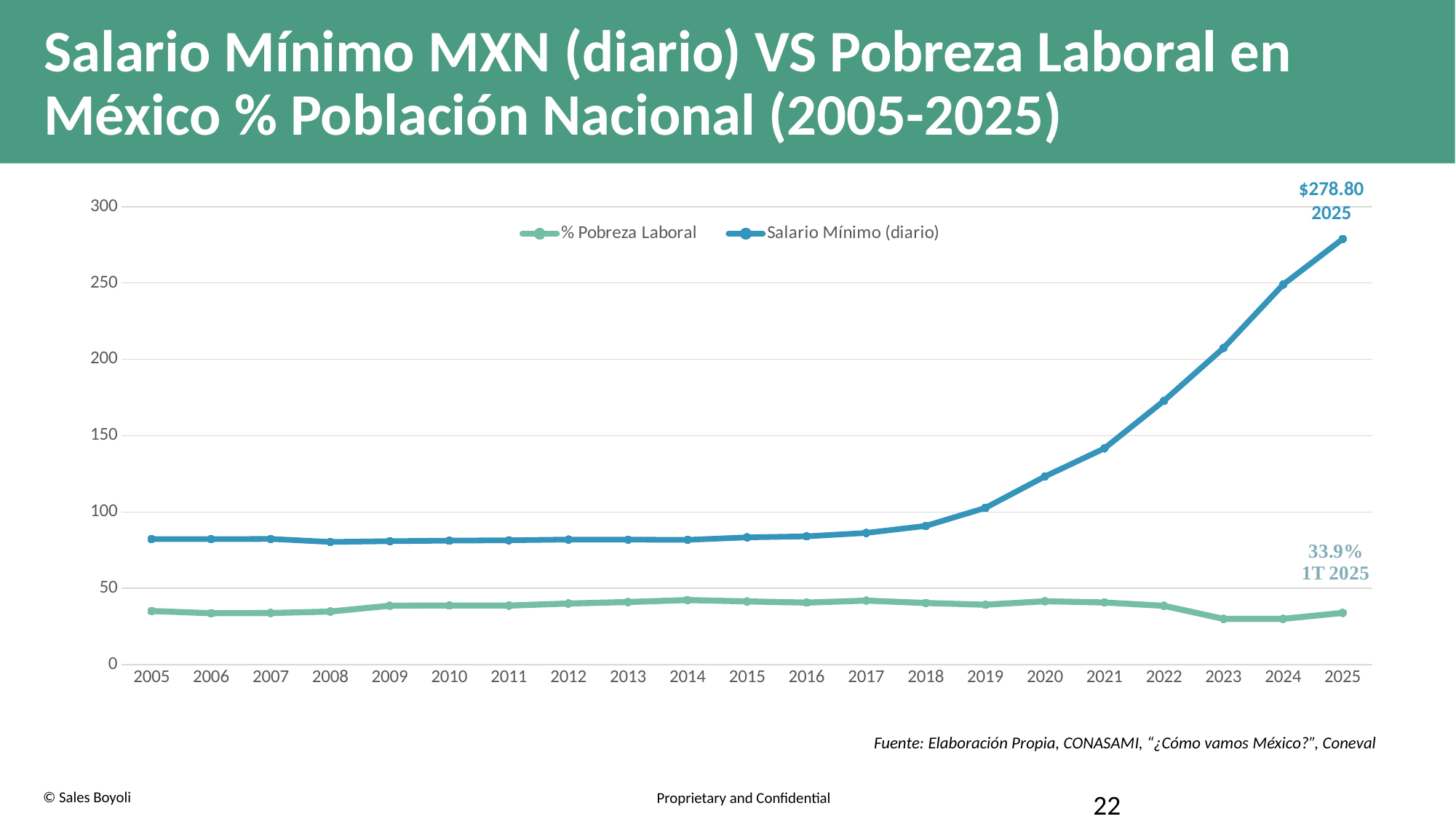
How many series does the legend list? 2 What is the value of Salario Mínimo (diario) in 2025? $278.80 How many years are plotted along the x axis? 21 Is the value for Salario Mínimo (diario) in 2024 greater or less than 200? greater Is the value for Salario Mínimo (diario) in 2015 greater or less than 100? less Which series is drawn in blue according to the legend? Salario Mínimo (diario) Is the value for % Pobreza Laboral in 2014 greater or less than 50? less Does Salario Mínimo (diario) rise or fall from 2018 to 2025? rise What kind of chart is shown on the slide? line chart In which year is Salario Mínimo (diario) highest? 2025 What is the value of % Pobreza Laboral labelled for 1T 2025? 33.9%